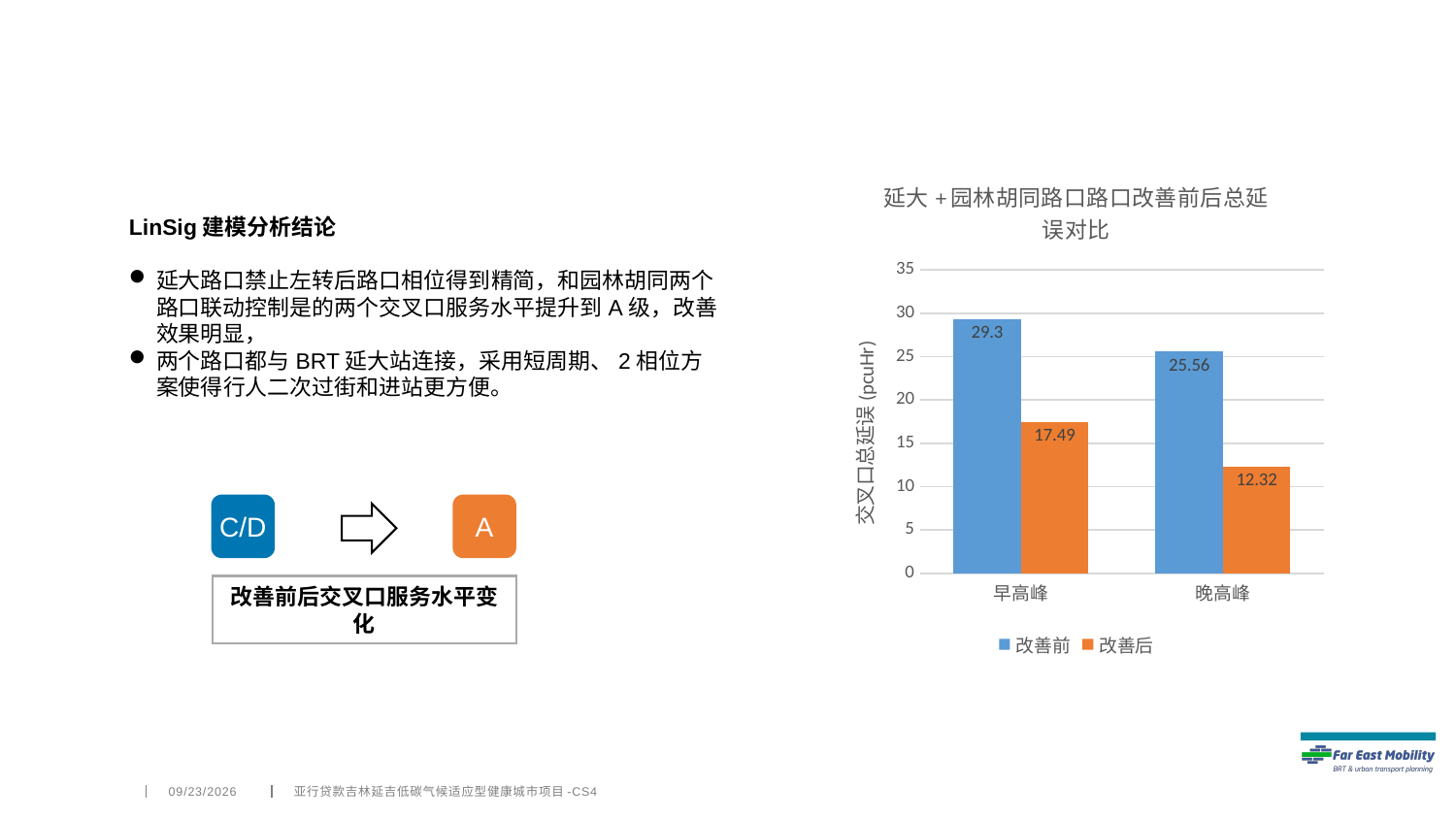
Which bar has the highest value in the chart? 改善前, 早高峰 What is the difference between 改善前 and 改善后 in the 早高峰 category? 11.81 How many categories are shown on the x axis? 2 How many series does the legend list? 2 What is the value for 改善前 in the 晚高峰 category? 25.56 What is the value for 改善后 in the 晚高峰 category? 12.32 What kind of chart is shown on the slide? Bar chart What is the difference between 改善前 and 改善后 in the 晚高峰 category? 13.24 Which bar has the lowest value in the chart? 改善后, 晚高峰 What is the value for 改善后 in the 早高峰 category? 17.49 Which is larger: 改善后 for 早高峰 or 改善后 for 晚高峰? 改善后 for 早高峰 What is the value for 改善前 in the 早高峰 category? 29.3